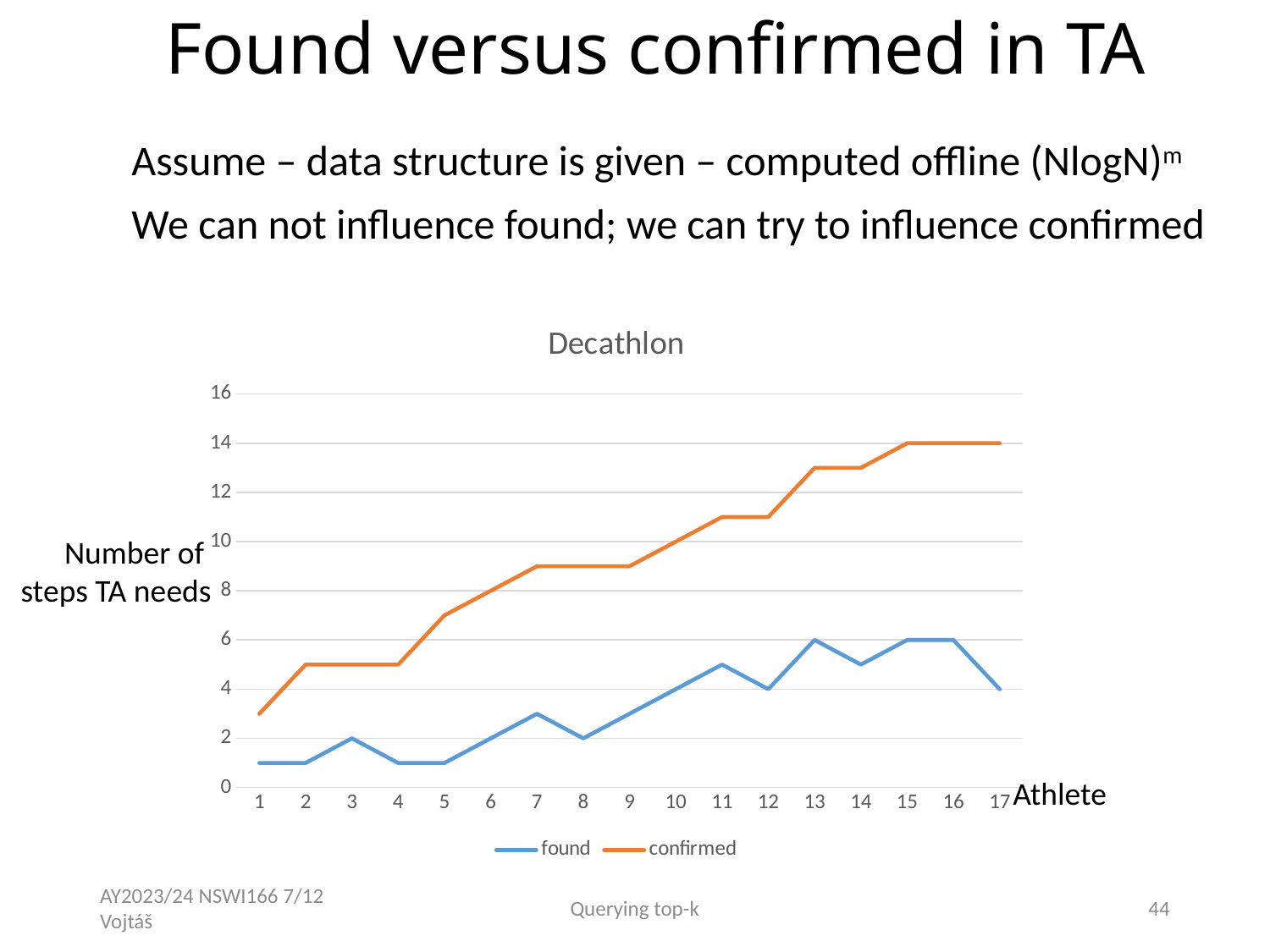
What is the value of the found series for athlete 3? 2 How many series does the legend list? 2 Which series has the higher value for athlete 10, found or confirmed? confirmed Does the confirmed series generally rise or fall from athlete 1 to athlete 17? rise What is the difference between the confirmed and found values for athlete 16? 8 Is the confirmed value for athlete 13 greater or less than 12? greater What is the value of the confirmed series for athlete 6? 8 What kind of chart is shown on the slide? line chart What is the value of the confirmed series for athlete 16? 14 What is the value of the found series for athlete 17? 4 How many athletes are plotted along the x axis? 17 What is the title of the chart? Decathlon